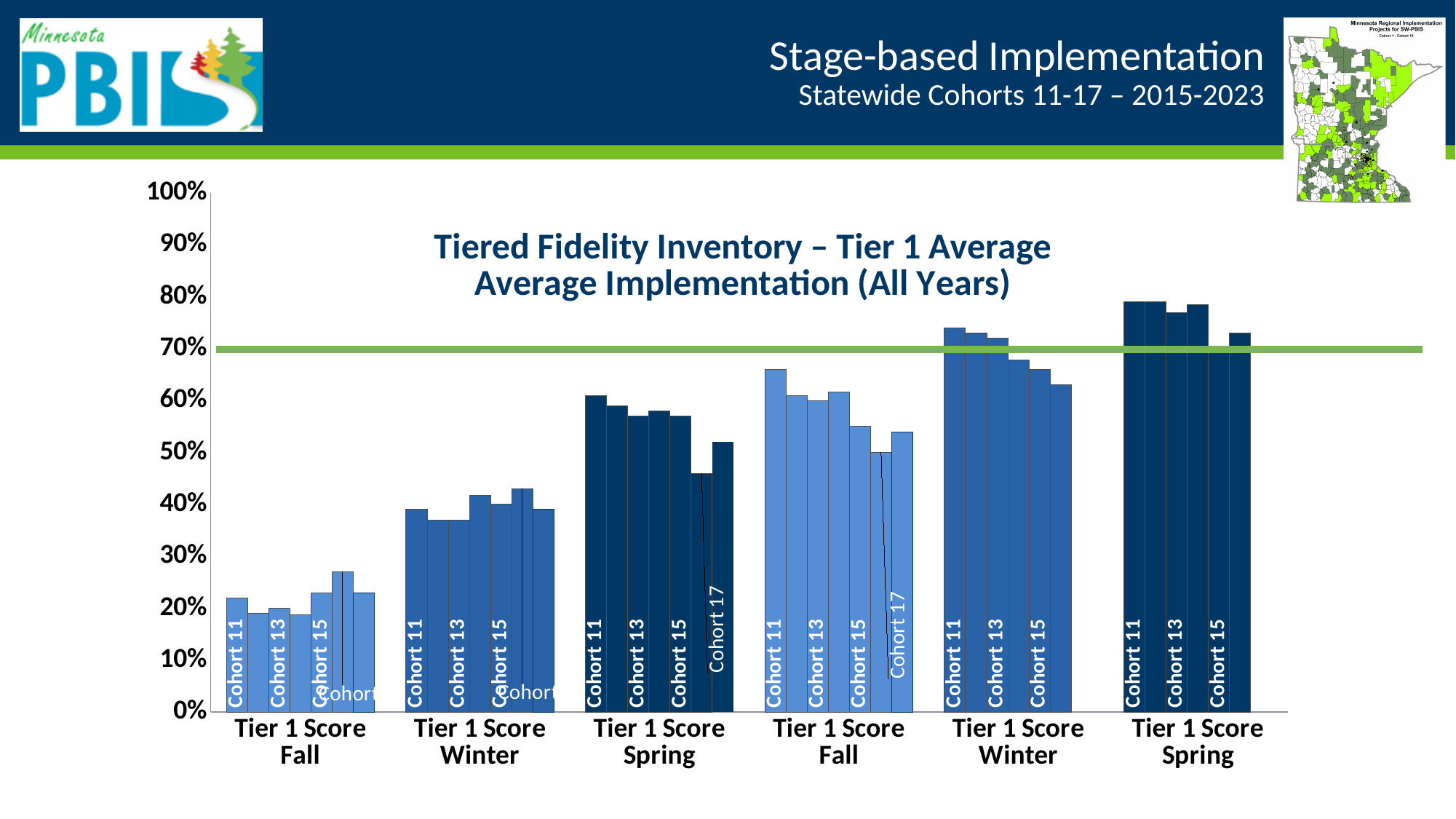
Which category group has the highest bars? Tier 1 Score Spring (rightmost group) What is the title of the chart? Tiered Fidelity Inventory – Tier 1 Average Average Implementation (All Years) At what percentage level is the horizontal green line drawn across the chart? 70% Which is larger: Cohort 11 in the first Tier 1 Score Spring group or Cohort 11 in the first Tier 1 Score Fall group? Cohort 11 in the first Tier 1 Score Spring group Do the Cohort 11 values generally rise or fall moving from the leftmost group to the rightmost group? Rise Is the value for Cohort 11 in the rightmost Tier 1 Score Spring group greater or less than 70%? greater Is the value for Cohort 11 in the leftmost Tier 1 Score Fall group greater or less than 30%? less Which category group has the lowest bars? Tier 1 Score Fall (leftmost group) What kind of chart is shown on the slide? Bar chart Is the value for Cohort 11 in the second Tier 1 Score Fall group greater or less than 70%? less How many Tier 1 Score category groups are shown along the x axis? 6